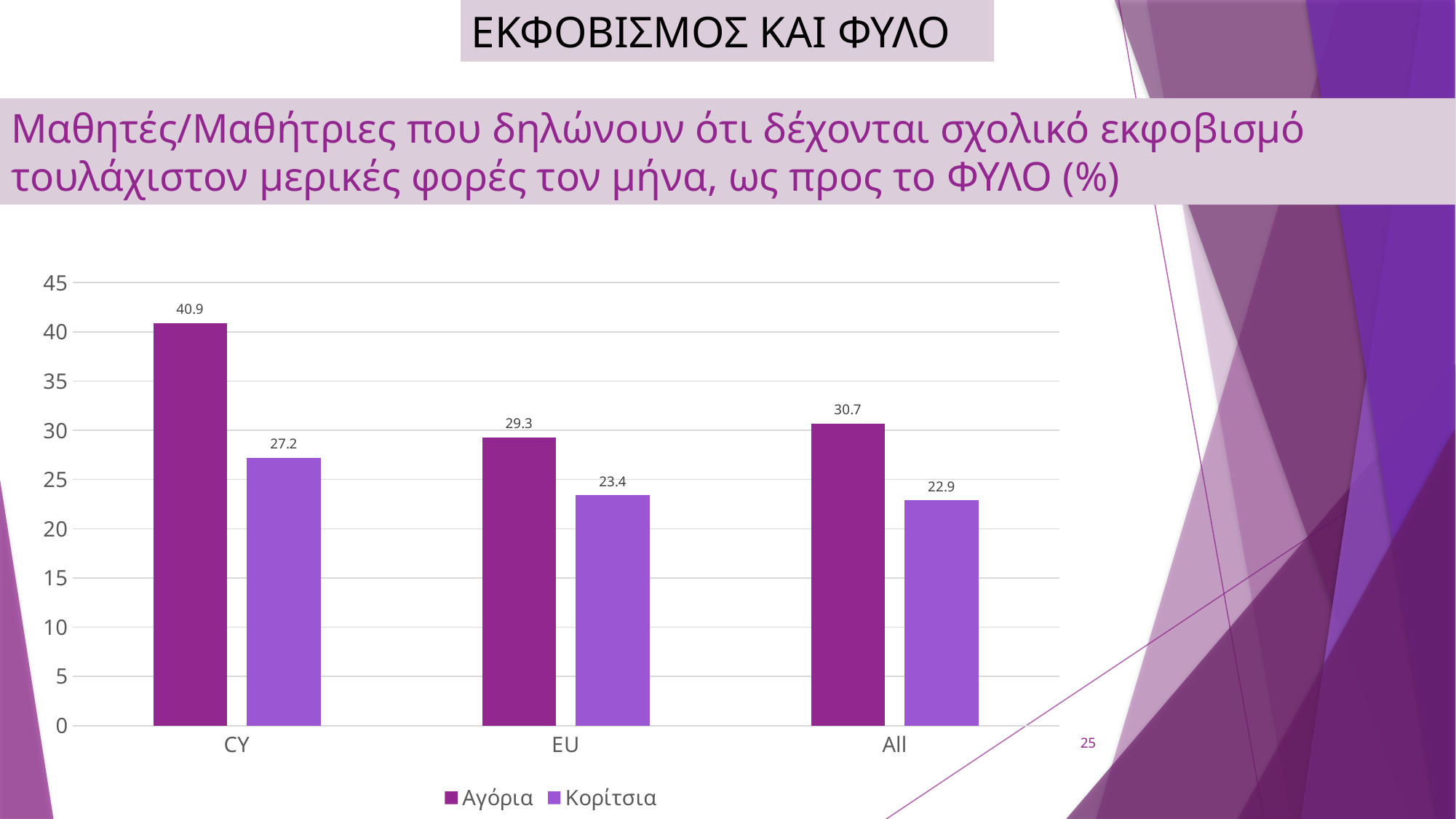
What is the difference between Αγόρια and Κορίτσια in All? 7.8 What is the difference between Αγόρια and Κορίτσια in CY? 13.7 What kind of chart is shown on the slide? Bar chart Which category has the highest value for Αγόρια? CY Is the value for Αγόρια in All greater or less than 30? greater What is the value for Κορίτσια in EU? 23.4 Which category has the lowest value for Κορίτσια? All What is the value for Κορίτσια in All? 22.9 How many series does the legend list? 2 How many categories are shown on the x axis? 3 Which is larger in EU, Αγόρια or Κορίτσια? Αγόρια What is the value for Αγόρια in CY? 40.9